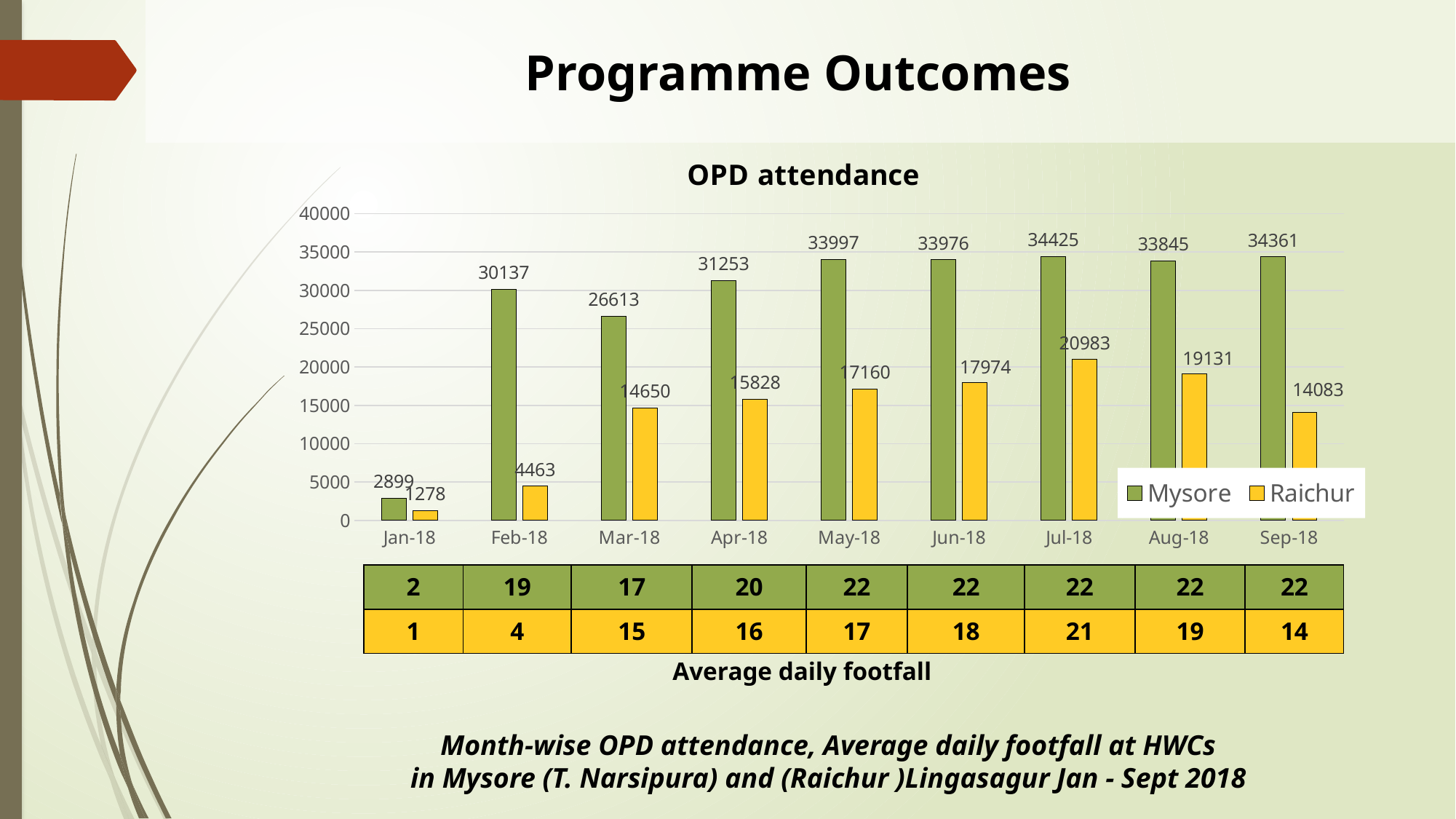
What is the OPD attendance for Mysore in Feb-18? 30137 Which is larger in Mar-18, the Mysore or the Raichur OPD attendance? Mysore In which month is the Mysore OPD attendance lowest? Jan-18 How many months are shown on the x axis of the OPD attendance chart? 9 Which colour represents Raichur in the OPD attendance chart? yellow Is the Raichur OPD attendance in Aug-18 greater or less than 15000? greater In which month is the Raichur OPD attendance highest? Jul-18 What type of chart is shown under the title 'OPD attendance'? bar chart What is the OPD attendance for Raichur in Sep-18? 14083 What is the OPD attendance for Raichur in Jul-18? 20983 What is the difference between the Mysore and Raichur OPD attendance in Jul-18? 13442 How many series does the legend of the OPD attendance chart list? 2